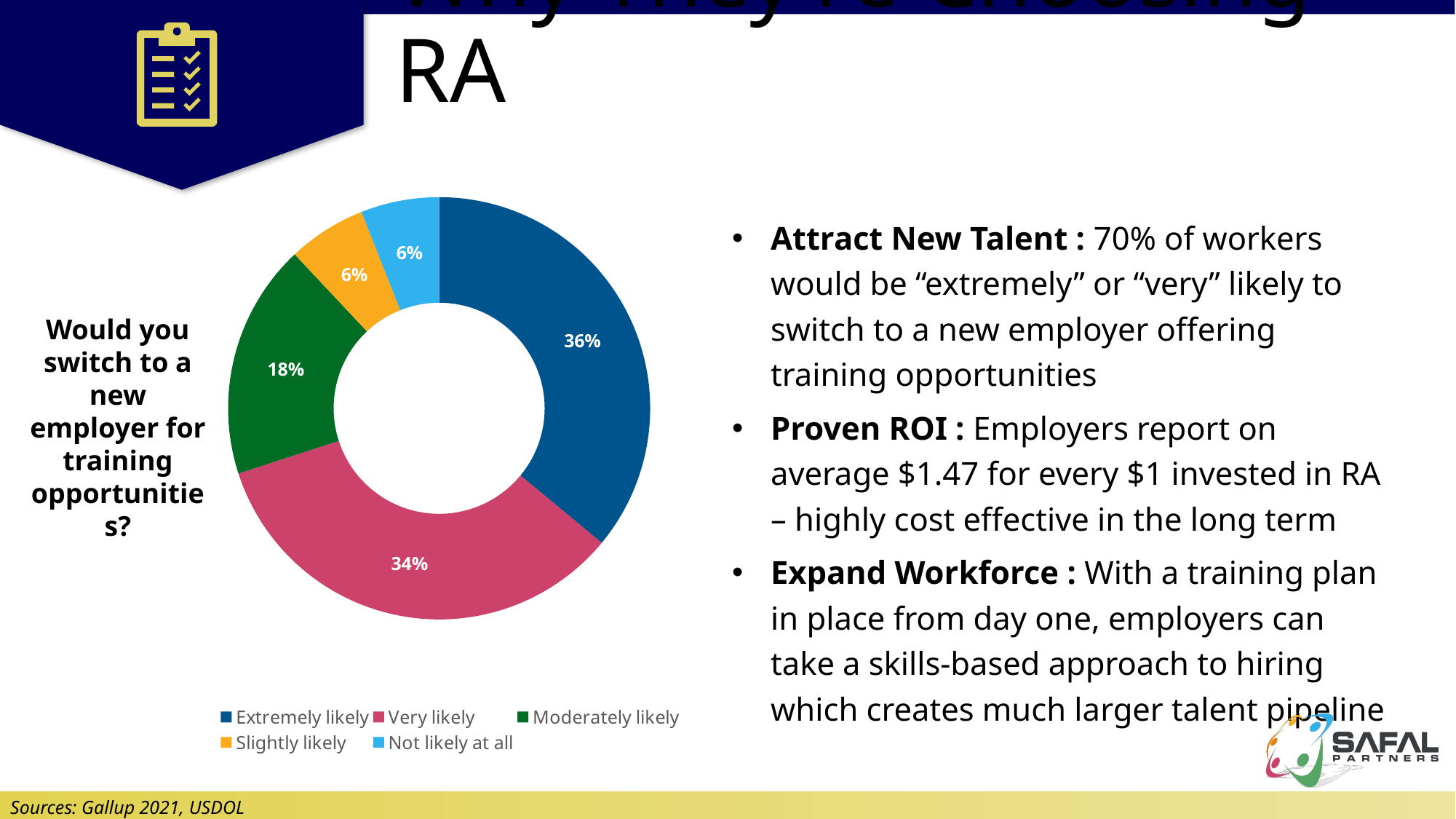
What is the difference in percentage points between the Extremely likely and Very likely slices? 2 percentage points How many response categories does the chart show? 5 What percentage of respondents said they would be extremely likely to switch to a new employer for training opportunities? 36% What is the combined share of the Extremely likely and Very likely slices? 70% Which response category has the largest share of the chart? Extremely likely What percentage of respondents were not likely at all to switch employers? 6% Which is larger, the Moderately likely slice or the Slightly likely slice? Moderately likely What colour is the Moderately likely slice in the chart? Green What percentage of respondents were slightly likely to switch employers? 6% What percentage of respondents were moderately likely to switch employers? 18% What share of the chart is labelled Very likely? 34% What kind of chart is shown on the slide? Doughnut (pie) chart